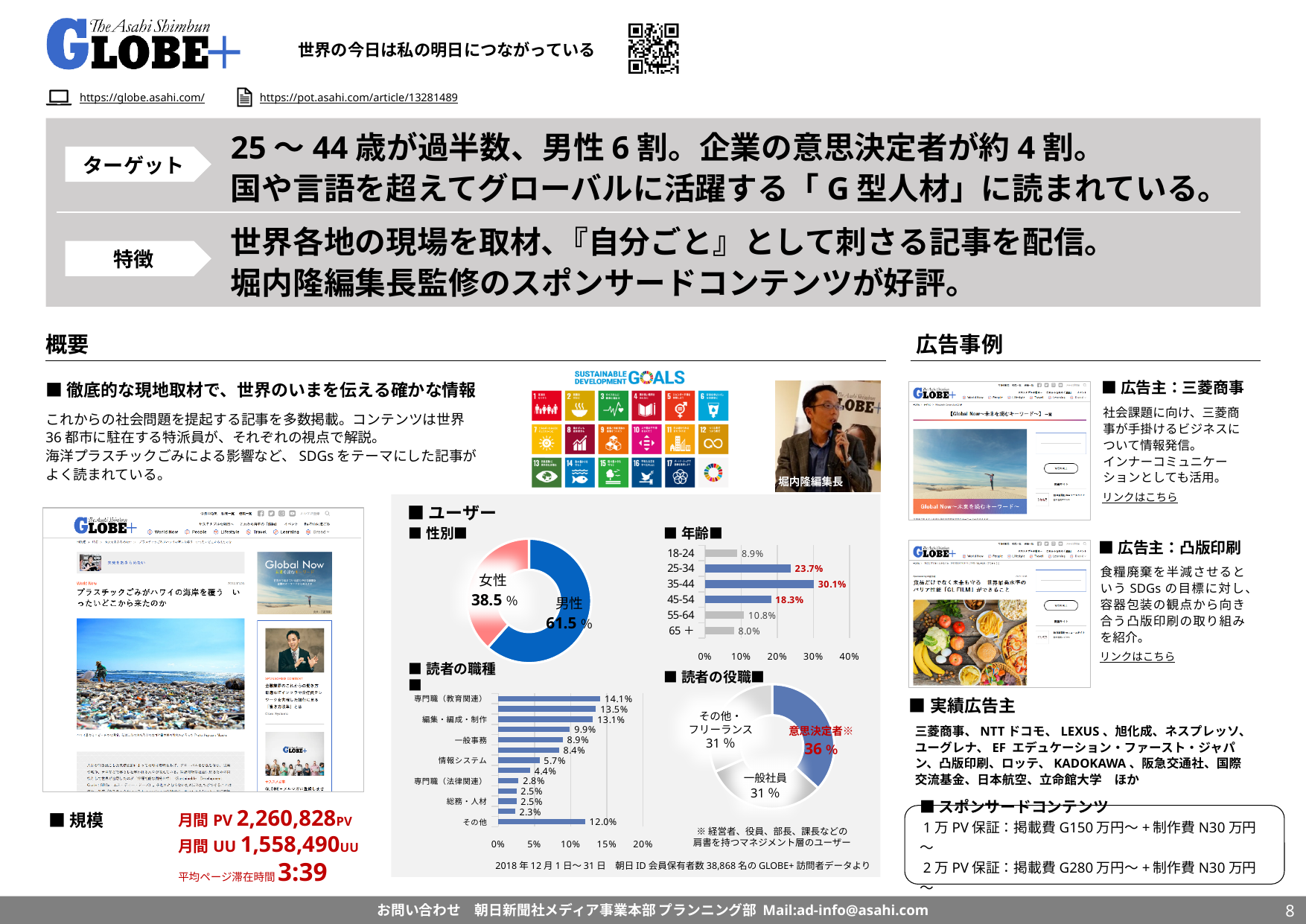
In the 読者の役職 chart, what is the value for 一般社員? 31% In the 年齢 chart, what is the difference between the 35-44 and 45-54 values? 11.8% In the 性別 chart, what is the value for 女性? 38.5% In the 年齢 chart, what is the value for 25-34? 23.7% What kind of chart is the 性別 chart? donut (pie) chart How many age groups are shown in the 年齢 chart? 6 In the 読者の職種 chart, what is the value for 専門職（教育関連）? 14.1% In the 年齢 chart, which age group has the highest value? 35-44 In the 読者の役職 chart, what is the share for 意思決定者? 36% In the 性別 chart, what is the value for 男性? 61.5% In the 年齢 chart, which age group has the lowest value? 65＋ In the 読者の職種 chart, which is larger, 一般事務 or 情報システム? 一般事務